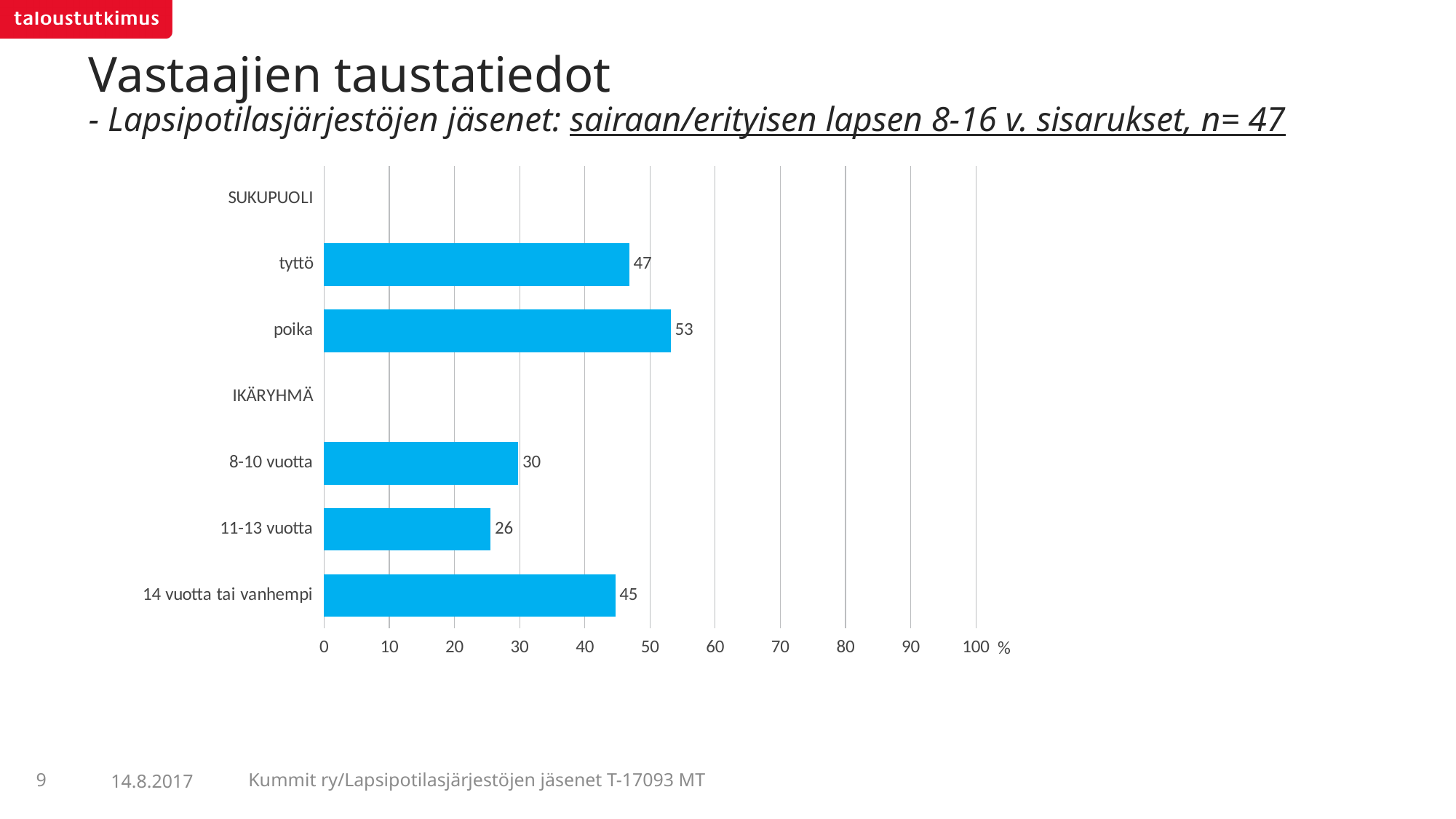
What is the value for 11-13 vuotta? 26 What is the value for poika? 53 What is the value for 8-10 vuotta? 30 What is the difference between the values for poika and tyttö? 6 What is the value for 14 vuotta tai vanhempi? 45 What is the value for tyttö? 47 What is the unit shown at the end of the x axis? % Which is larger, the value for 8-10 vuotta or 11-13 vuotta? 8-10 vuotta Which age group (IKÄRYHMÄ) has the highest value? 14 vuotta tai vanhempi Which age group (IKÄRYHMÄ) has the lowest value? 11-13 vuotta What kind of chart is shown on the slide? bar chart Is the value for 14 vuotta tai vanhempi greater or less than 50? less